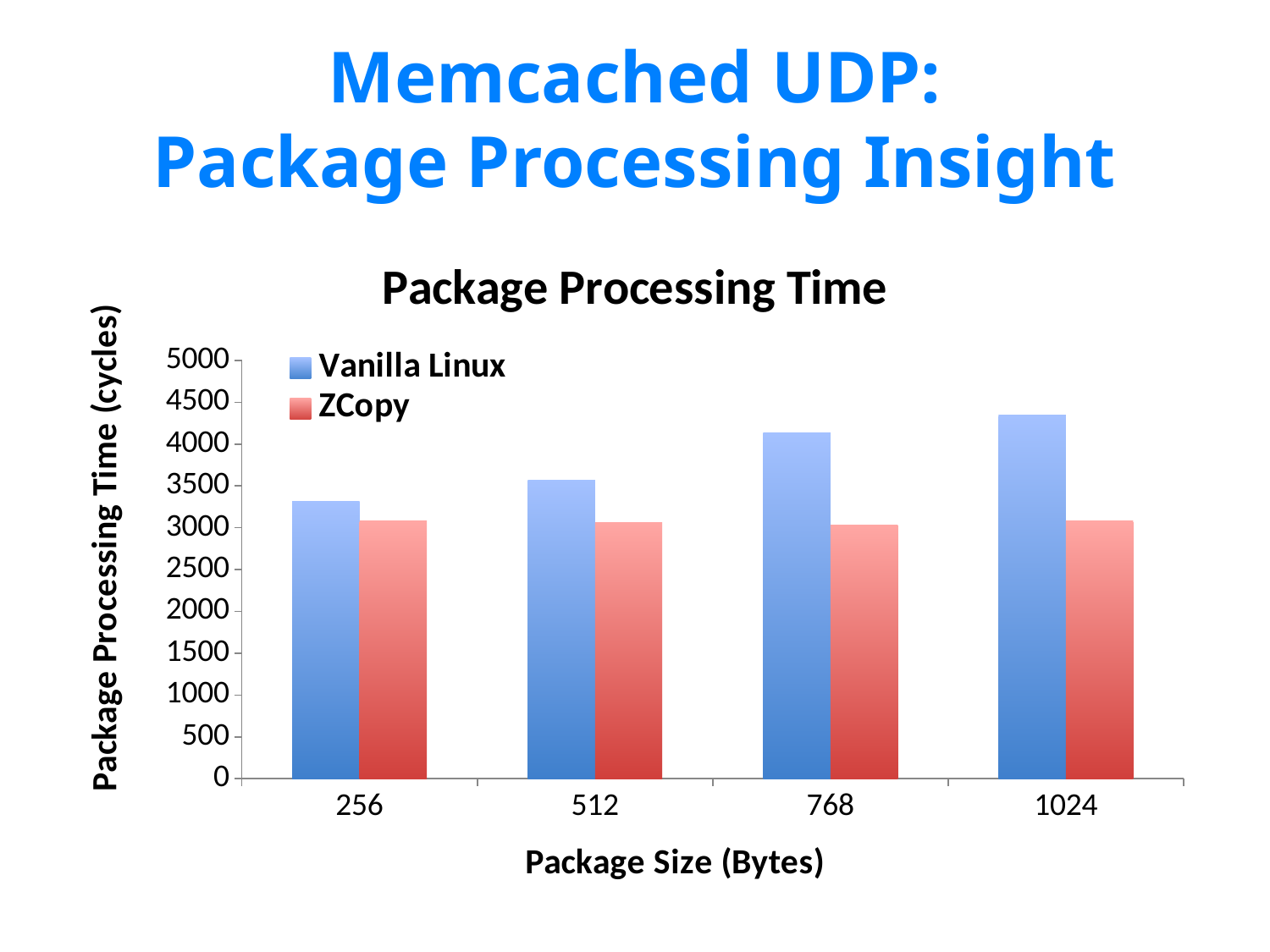
Is the Vanilla Linux value for a package size of 512 greater or less than 4000? less How many package sizes are shown on the x axis? 4 Is the ZCopy value for a package size of 768 greater or less than 3500? less For which package size is the Vanilla Linux processing time lowest? 256 Does the Vanilla Linux processing time rise or fall as package size increases? rise For which package size is the Vanilla Linux processing time highest? 1024 At a package size of 768 bytes, which series has the larger processing time, Vanilla Linux or ZCopy? Vanilla Linux Is the Vanilla Linux value for a package size of 1024 greater or less than 4000? greater How many series does the legend list? 2 What is the label of the y axis? Package Processing Time (cycles) What kind of chart is shown on the slide? bar chart